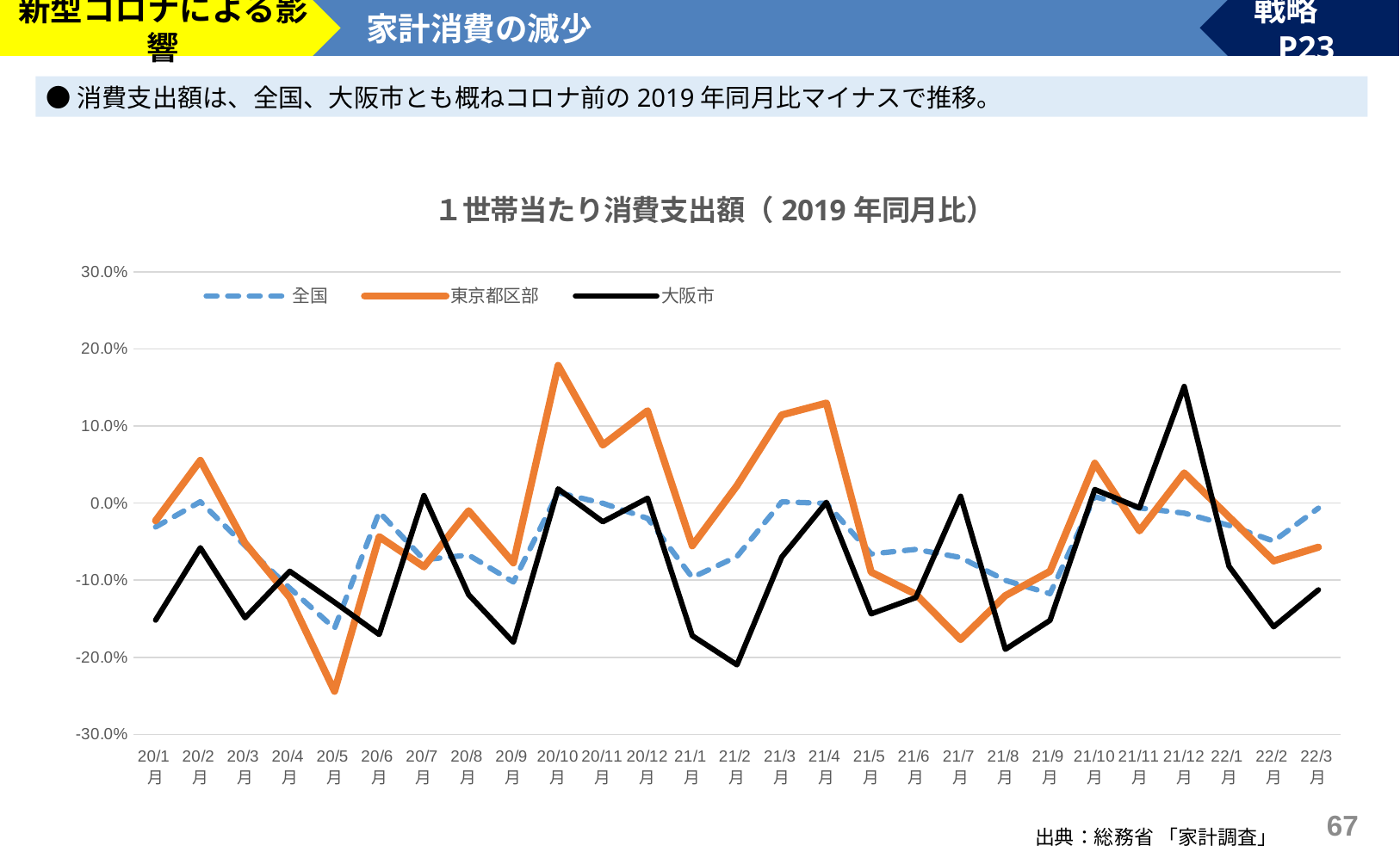
In which month does 大阪市 reach its highest value? 21/12月 In which month does 東京都区部 reach its lowest value? 20/5月 Is the value for 東京都区部 in 20/10月 greater or less than 10.0%? greater What kind of chart is shown on the slide? Line chart Is the value for 大阪市 in 21/12月 greater or less than 10.0%? greater Is the value for 東京都区部 in 20/5月 greater or less than -20.0%? less How many months are plotted along the x axis? 27 What are the three series named in the legend? 全国, 東京都区部, 大阪市 In 21/12月, which series has the larger value, 大阪市 or 東京都区部? 大阪市 How many series does the legend list? 3 What is the title of the chart? １世帯当たり消費支出額（2019年同月比）